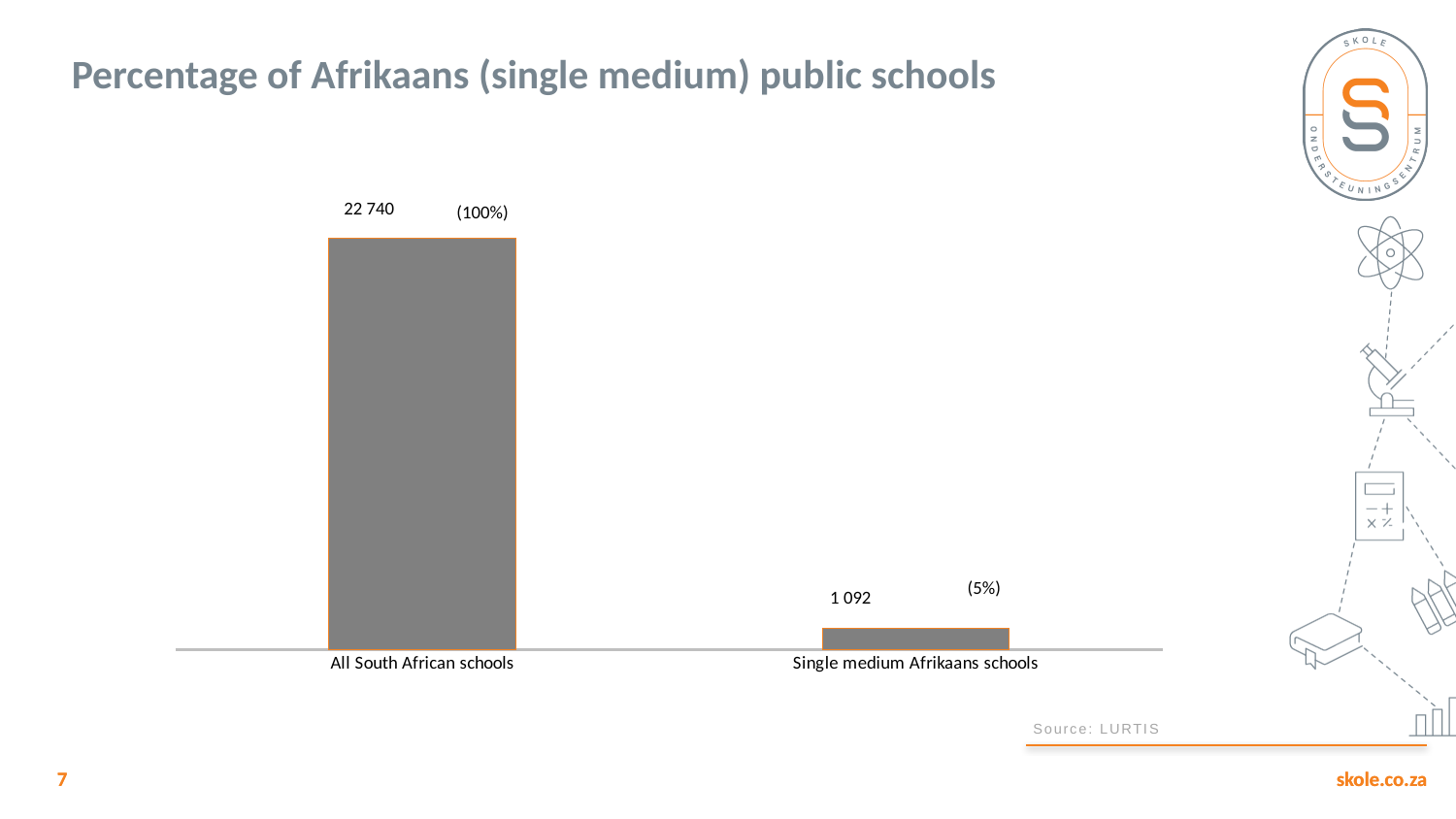
What percentage is shown next to the Single medium Afrikaans schools bar? (5%) How many categories are shown in the chart? 2 What source is cited for the chart? LURTIS What percentage is shown next to the All South African schools bar? (100%) What is the value for Single medium Afrikaans schools? 1 092 What is the value for All South African schools? 22 740 Which category has the lowest value? Single medium Afrikaans schools Which is larger, the value for All South African schools or for Single medium Afrikaans schools? All South African schools What is the difference between the values for All South African schools and Single medium Afrikaans schools? 21 648 What kind of chart is shown on the slide? Bar chart What is the title of the slide? Percentage of Afrikaans (single medium) public schools Which category has the highest value? All South African schools